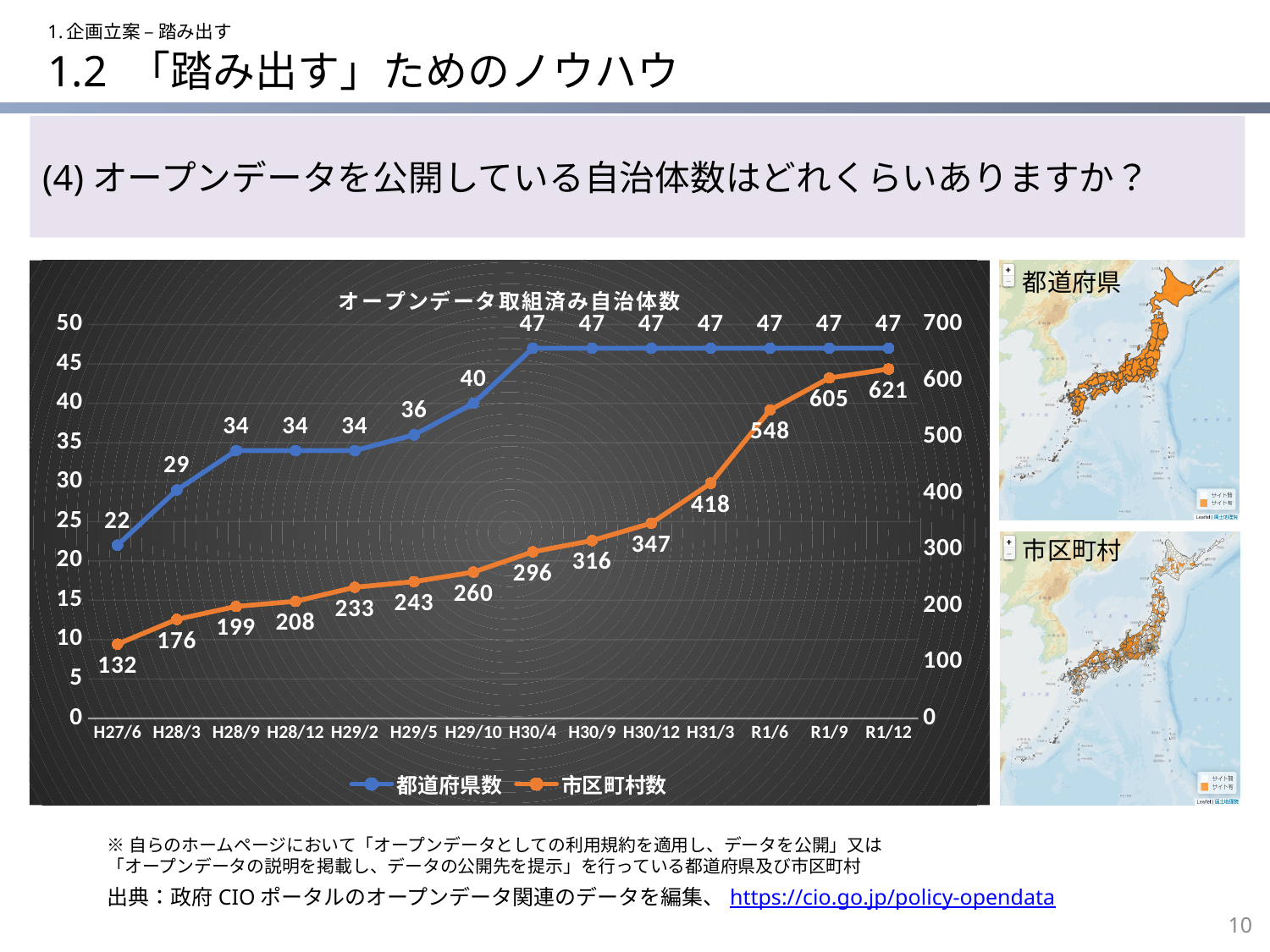
What is the title of the chart? オープンデータ取組済み自治体数 Which is larger, 市区町村数 at H31/3 or at H30/12? H31/3 How many time points are plotted along the x axis? 14 What is the value of 都道府県数 at H29/10? 40 At which time point is 市区町村数 lowest? H27/6 What is the value of 市区町村数 at H27/6? 132 What type of chart is shown on the slide? line chart How many series does the chart legend list? 2 What is the difference in 市区町村数 between R1/12 and H27/6? 489 Does 市区町村数 rise or fall from H27/6 to R1/12? rise What is the difference in 都道府県数 between H30/4 and H27/6? 25 What is the value of 市区町村数 at R1/12? 621